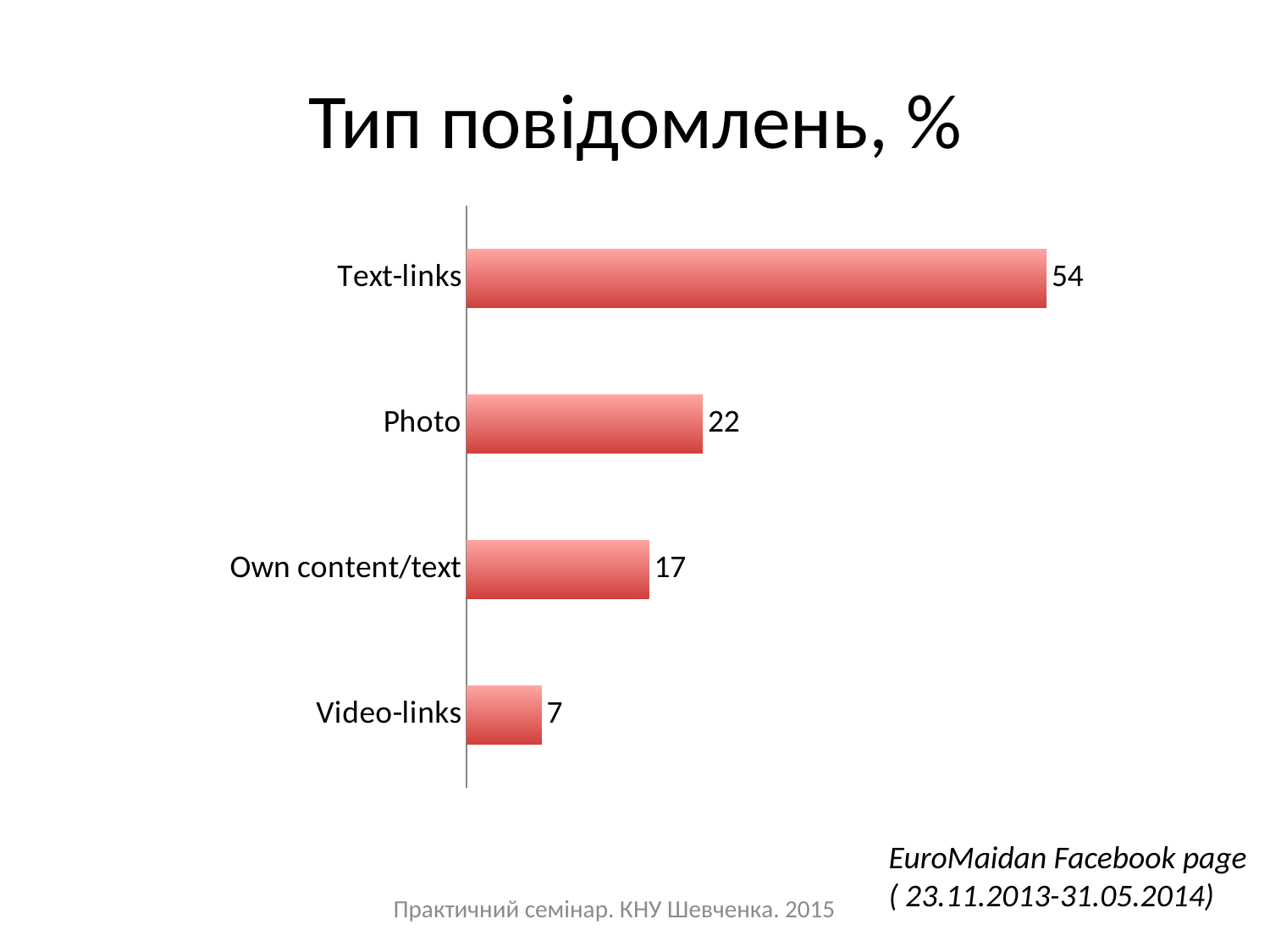
Which category has the highest value? Text-links What is the value for Text-links? 54 What kind of chart is shown on the slide? Bar chart How many categories are shown in the chart? 4 What is the value for Video-links? 7 What is the difference between the values for Photo and Own content/text? 5 What is the difference between the values for Text-links and Photo? 32 What is the value for Own content/text? 17 Which category has the lowest value? Video-links What is the title of the slide? Тип повідомлень, % Which is larger, the value for Own content/text or the value for Video-links? Own content/text What is the value for Photo? 22